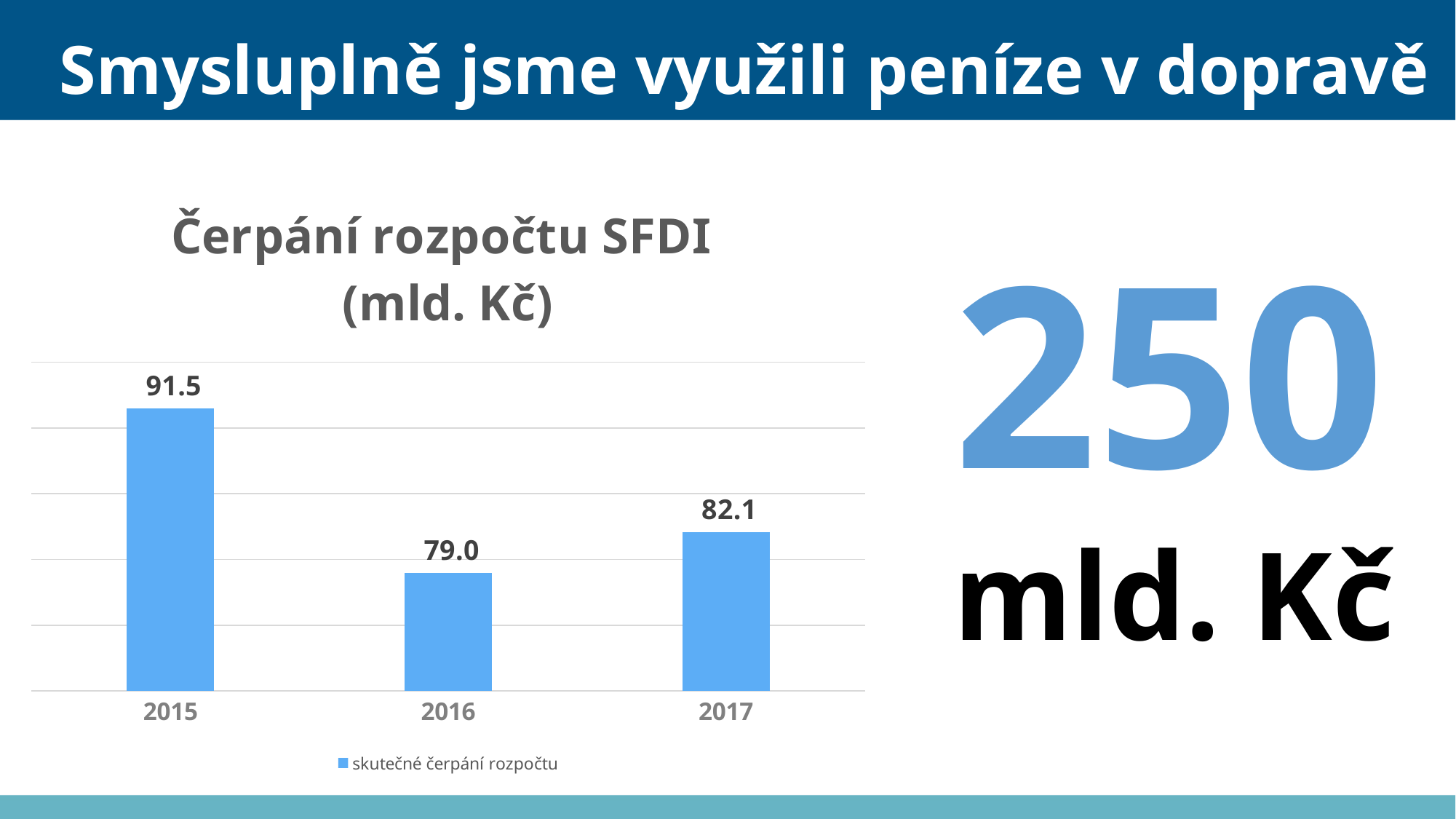
How many years are shown on the x axis? 3 Which year has the highest value? 2015 What is the difference between the values for 2015 and 2016? 12.5 What is the value for 2017? 82.1 What is the value for 2016? 79.0 How many series does the legend list? 1 What is the difference between the values for 2017 and 2016? 3.1 Which year has the lowest value? 2016 Which is larger, the value for 2016 or the value for 2017? 2017 What kind of chart is shown? bar chart What is the value for 2015? 91.5 What is the title of the chart? Čerpání rozpočtu SFDI (mld. Kč)